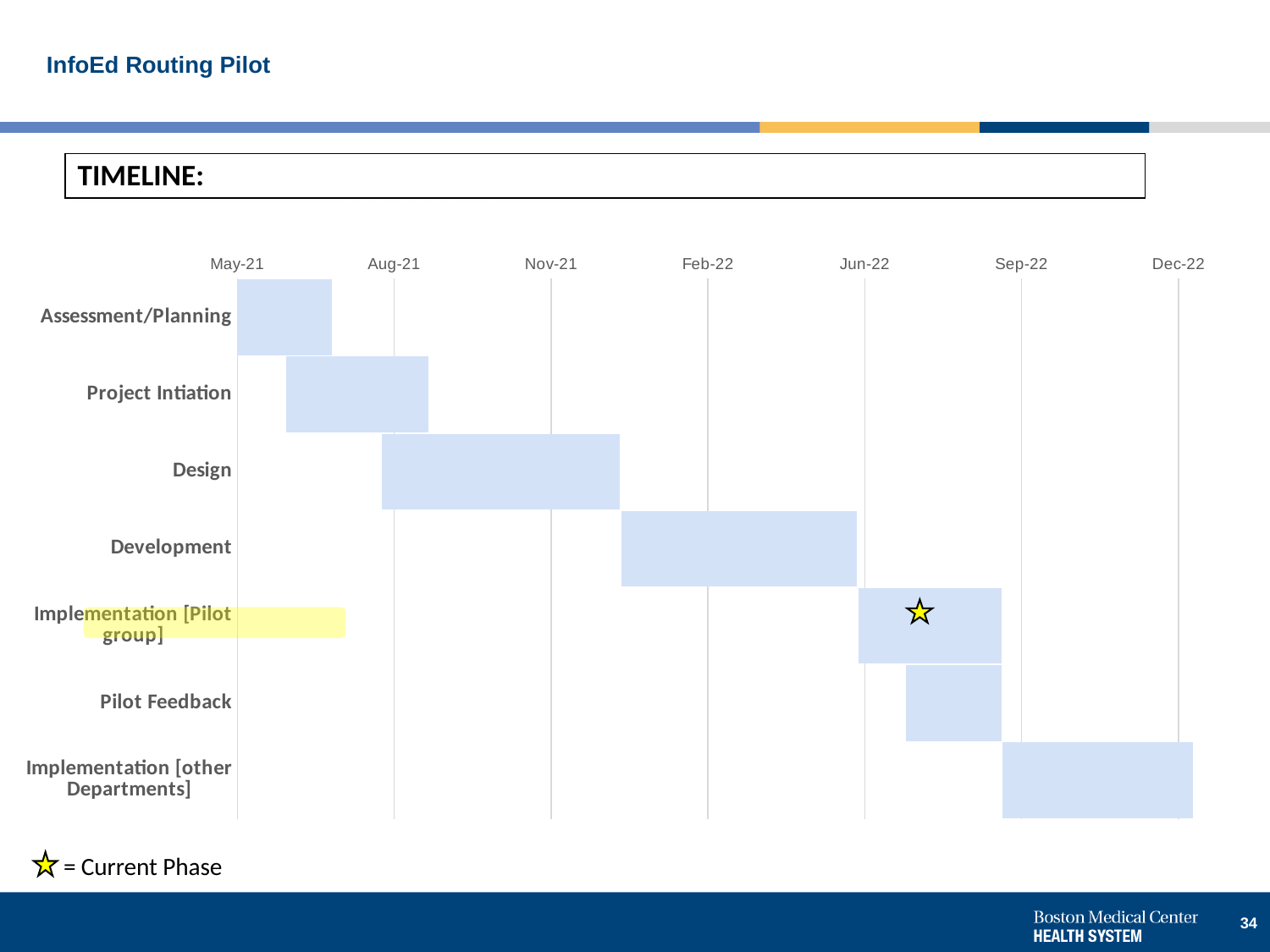
Does the Design phase end before or after Feb-22? before Which phase begins at the Sep-22 tick on the timeline? Implementation [other Departments] Which phase is marked with the star as the current phase? Implementation [Pilot group] Which phase begins at the Jun-22 tick on the timeline? Implementation [Pilot group] What does the star symbol represent according to the legend below the chart? Current Phase Which phase starts earliest on the timeline? Assessment/Planning Does the Development phase start before or after Feb-22? before How many phases are listed on the vertical axis of the timeline chart? 7 Which phase starts earlier, Design or Development? Design Which phase starts later, Pilot Feedback or Implementation [Pilot group]? Pilot Feedback Which phase ends latest on the timeline? Implementation [other Departments] What kind of chart is shown on the slide? Bar chart (Gantt chart)